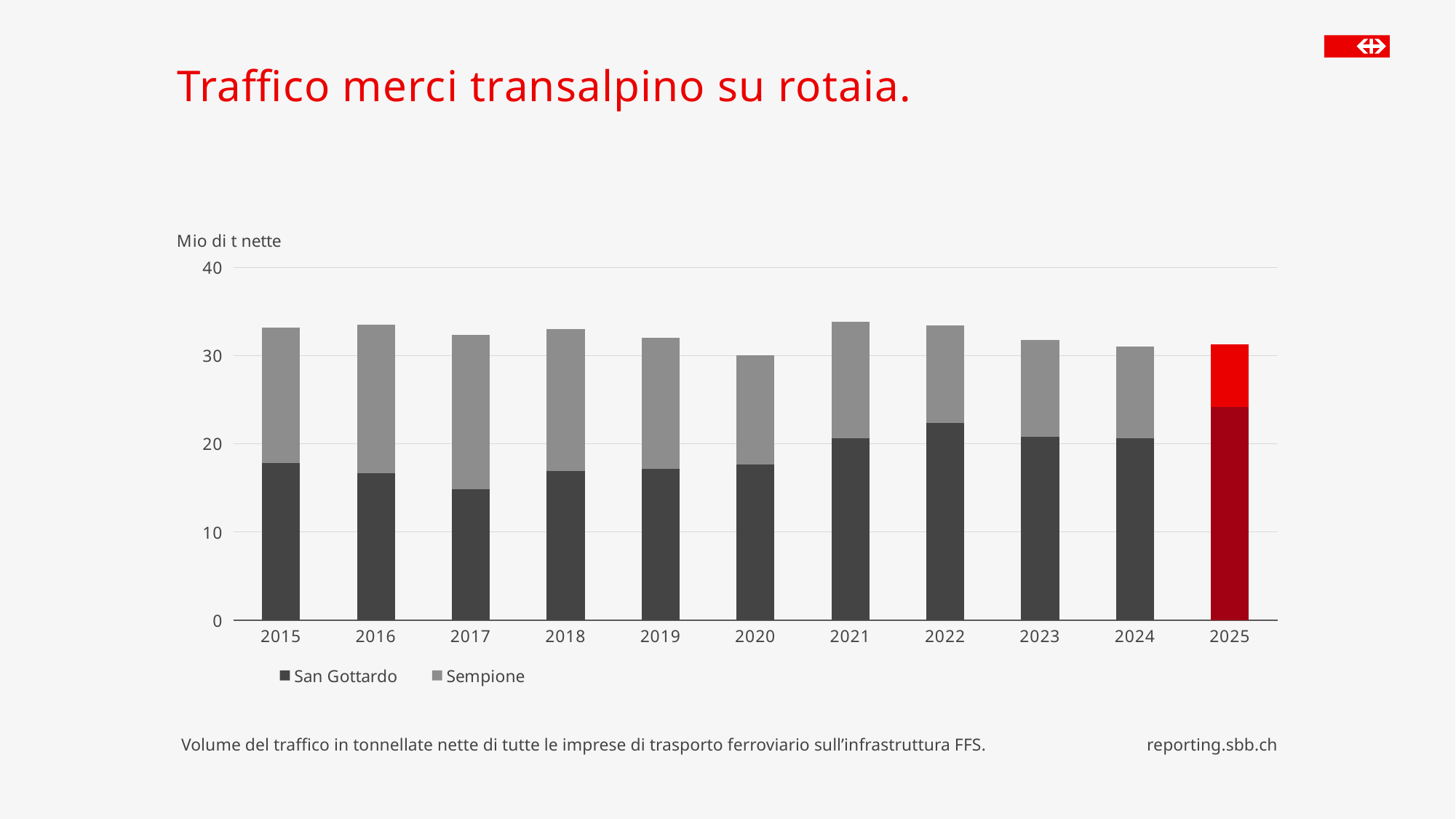
Which year has the lowest total transalpine rail freight volume? 2020 What kind of chart is shown on the slide? Stacked bar chart How many years are shown on the x axis of the chart? 11 Is the San Gottardo value for 2017 greater or less than 20? less Which year has the larger total value, 2020 or 2021? 2021 Is the total value for 2021 greater or less than 30? greater Is the San Gottardo value for 2022 greater or less than 20? greater What unit is shown on the chart's vertical axis label? Mio di t nette In which year is the San Gottardo value the lowest? 2017 In which year is the San Gottardo value the highest? 2025 How many series does the chart's legend list? 2 Which year has the larger San Gottardo value, 2017 or 2022? 2022